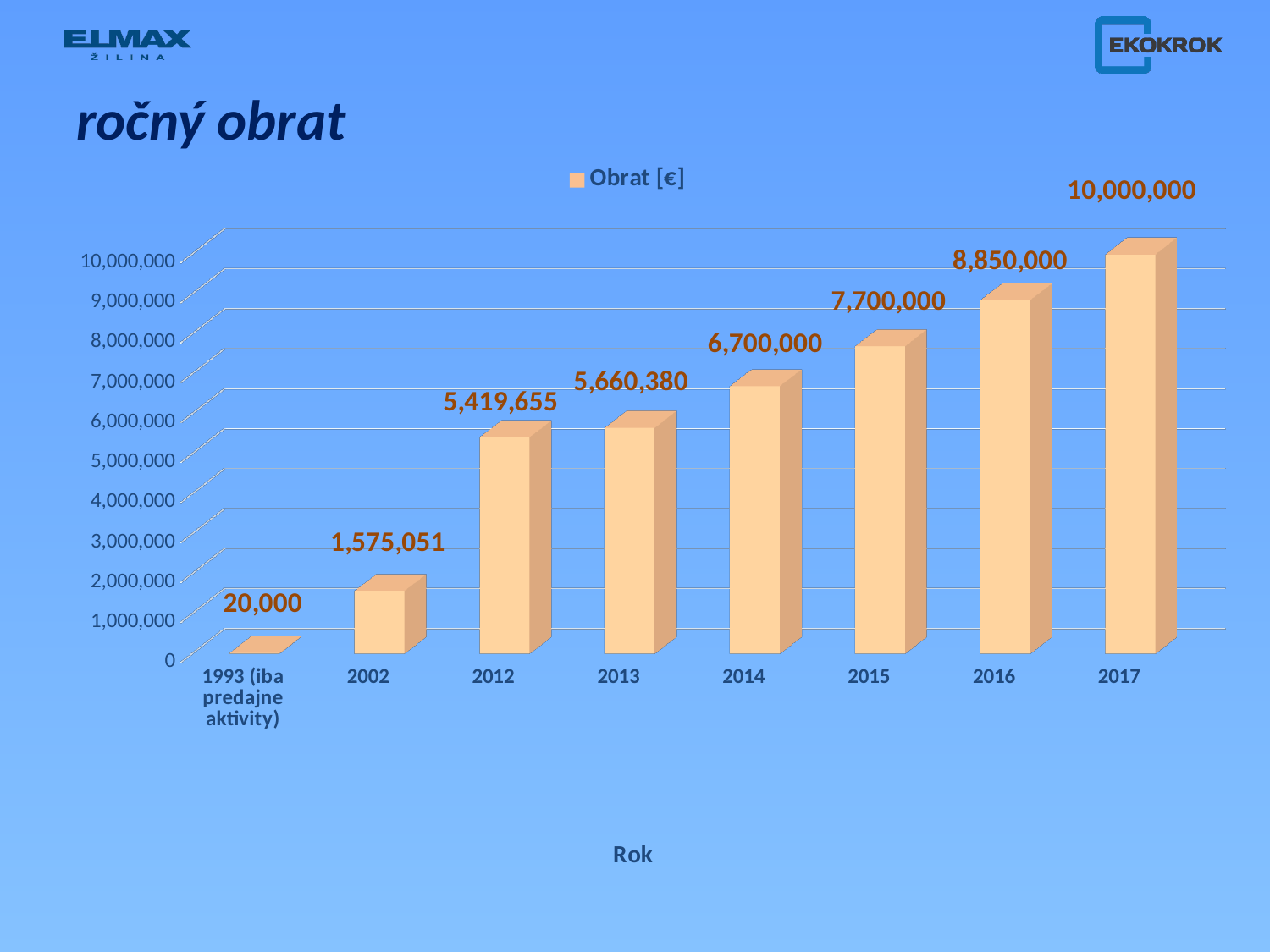
Do the Obrat [€] values rise or fall from 1993 to 2017? rise What is the difference between the Obrat [€] values for 2017 and 2016? 1,150,000 How many categories are shown on the x axis? 8 What is the Obrat [€] value for 2002? 1,575,051 What is the difference between the Obrat [€] values for 2013 and 2012? 240,725 Which category has the lowest Obrat [€] value? 1993 (iba predajne aktivity) Which year has the highest Obrat [€] value? 2017 What kind of chart is shown on the slide? bar chart What is the Obrat [€] value for 2014? 6,700,000 How many series does the legend list? 1 What is the Obrat [€] value for 2013? 5,660,380 Which is larger, the Obrat [€] value for 2015 or for 2014? 2015